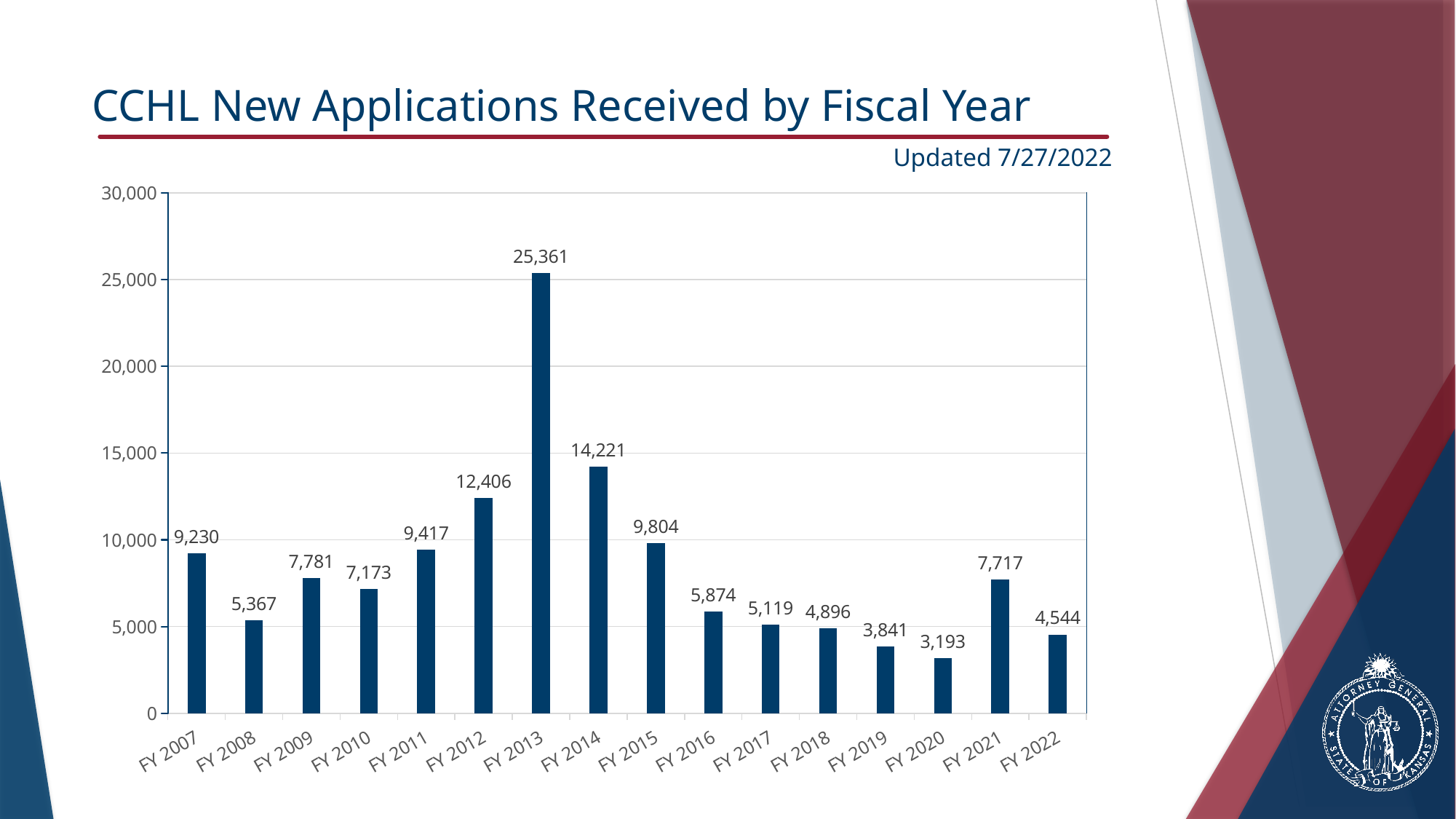
Do the values rise or fall from FY 2013 to FY 2020? fall How many new applications were received in FY 2013? 25,361 How many fiscal years are shown on the x axis? 16 What is the difference between the values for FY 2013 and FY 2014? 11,140 Which fiscal year has the highest number of new applications received? FY 2013 Is the value for FY 2014 greater or less than 15,000? less Which fiscal year has the lowest number of new applications received? FY 2020 Which fiscal year has a larger value, FY 2012 or FY 2015? FY 2012 What kind of chart is shown on the slide? bar chart How many new applications were received in FY 2022? 4,544 What is the value shown for FY 2020? 3,193 How much higher is the value for FY 2021 than the value for FY 2020? 4,524